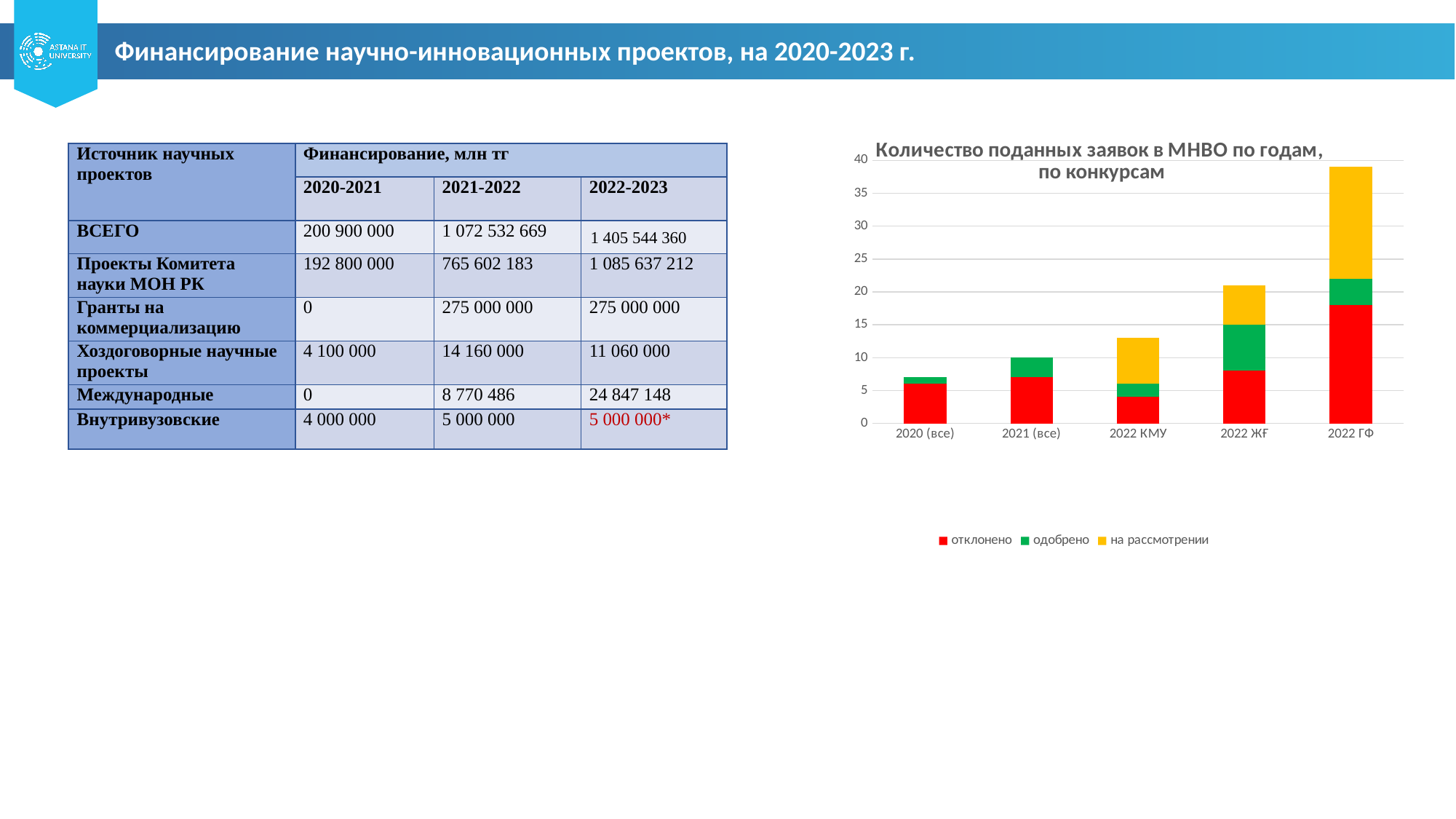
Which category has the tallest stacked bar in the chart? 2022 ГФ Is the total height of the bar for 2022 КМУ greater or less than 10? greater Which legend series is shown in yellow in the chart? на рассмотрении What kind of chart is shown on the right side of the slide? bar chart How many categories are shown on the x axis of the chart 'Количество поданных заявок в МНВО по годам, по конкурсам'? 5 How many series does the legend of the chart list? 3 Is the total height of the bar for 2022 ЖҒ greater or less than 25? less Do the total bar heights rise or fall from left to right along the x axis? rise Which stacked bar is taller: 2022 ЖҒ or 2022 КМУ? 2022 ЖҒ Is the total height of the bar for 2022 ГФ greater or less than 35? greater Which category has the shortest stacked bar in the chart? 2020 (все)